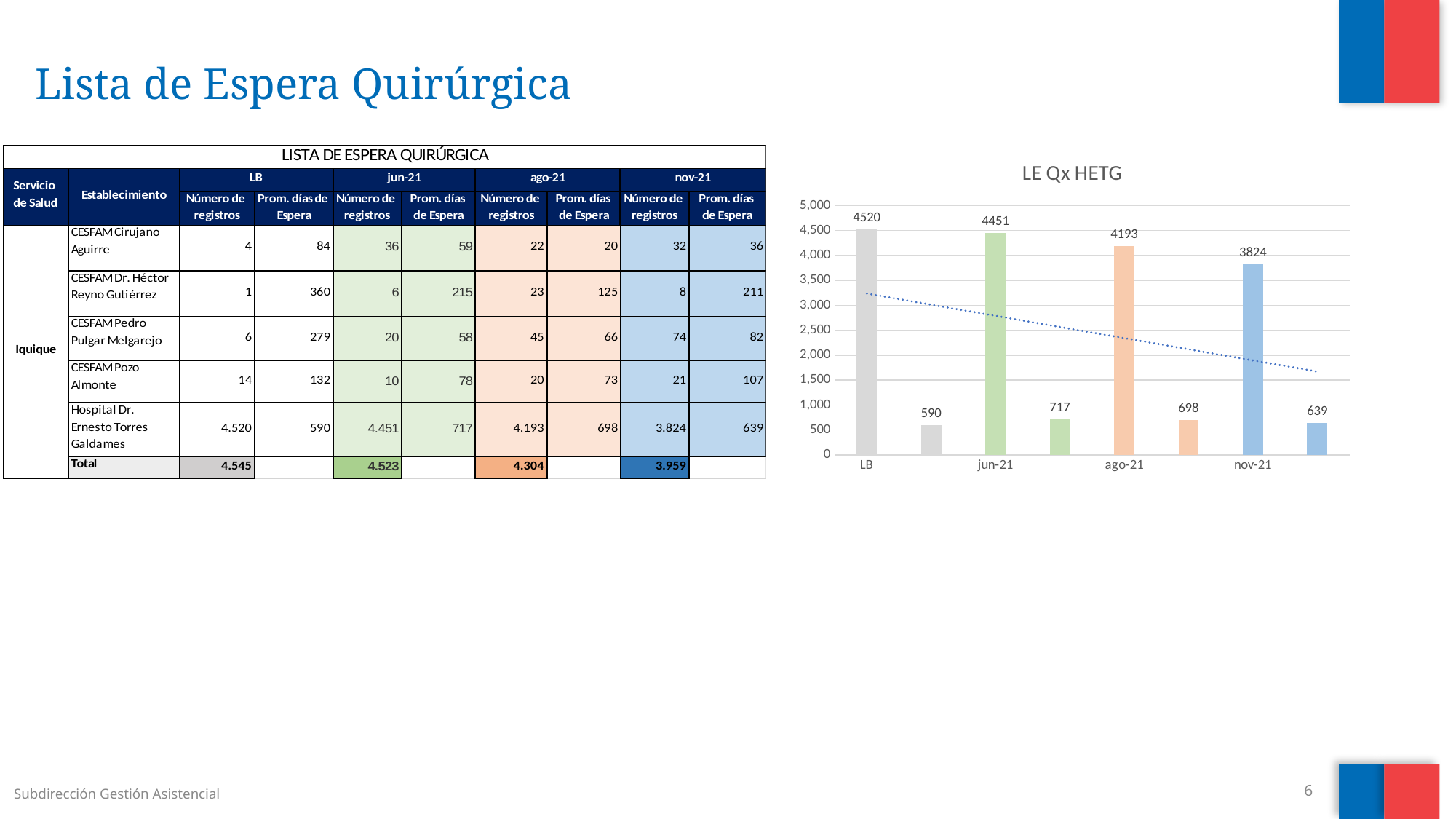
In the "LE Qx HETG" chart, what is the value of the taller bar for LB? 4520 In the "LE Qx HETG" chart, what is the value of the shorter bar for ago-21? 698 In the "LE Qx HETG" chart, what is the value of the shorter bar for jun-21? 717 In the "LE Qx HETG" chart, do the values of the taller bars rise or fall from LB to nov-21? fall What type of chart is "LE Qx HETG"? bar chart In the "LE Qx HETG" chart, how many categories are shown on the x axis? 4 In the "LE Qx HETG" chart, which category has the lowest value among the shorter bars? LB In the "LE Qx HETG" chart, which category has the highest value among the taller bars? LB In the "LE Qx HETG" chart, is the shorter bar for jun-21 larger or smaller than the shorter bar for nov-21? larger In the "LE Qx HETG" chart, what is the difference between the taller bar for LB (4520) and the taller bar for nov-21 (3824)? 696 What is the title of the chart on the right of the slide? LE Qx HETG In the "LE Qx HETG" chart, what is the value of the taller bar for nov-21? 3824